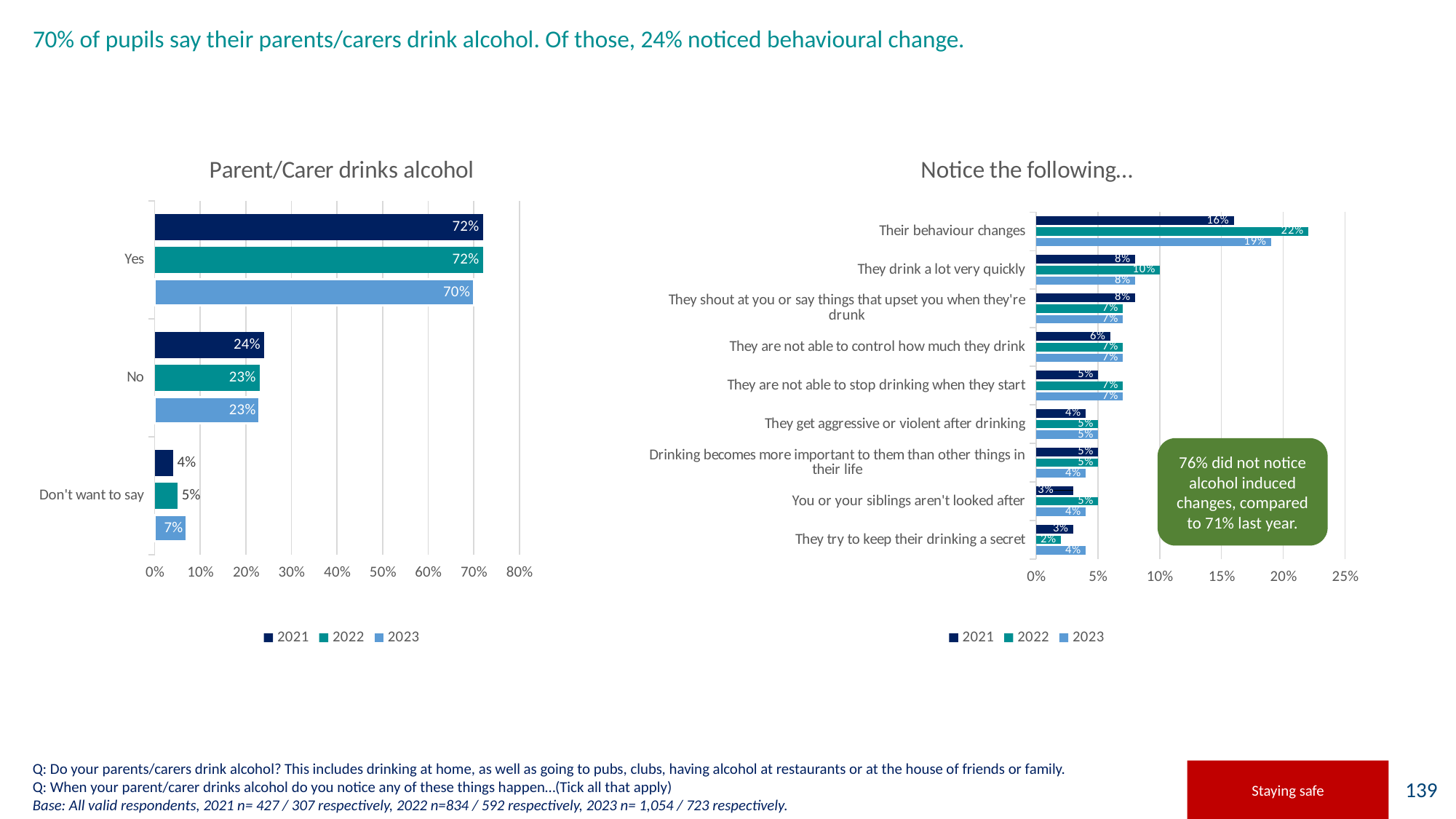
In the 'Notice the following...' chart, how many categories are shown? 9 In the 'Parent/Carer drinks alcohol' chart, what is the difference between the 2021 and 2023 values for 'Don't want to say'? 3% In the 'Parent/Carer drinks alcohol' chart, what is the 2023 value for 'Yes'? 70% In the 'Parent/Carer drinks alcohol' chart, what is the 2023 value for 'Don't want to say'? 7% In the 'Notice the following...' chart, what is the difference between the 2022 and 2023 values for 'Their behaviour changes'? 3% In the 'Parent/Carer drinks alcohol' chart, what is the 2021 value for 'No'? 24% In the 'Notice the following...' chart, what is the 2023 value for 'They drink a lot very quickly'? 8% In the 'Notice the following...' chart, which is larger for 'Their behaviour changes': the 2021 value or the 2022 value? 2022 What kind of chart is 'Notice the following...'? Bar chart In the 'Notice the following...' chart, which category has the highest 2023 value? Their behaviour changes In the 'Parent/Carer drinks alcohol' chart, how many series does the legend list? 3 In the 'Notice the following...' chart, what is the 2022 value for 'Their behaviour changes'? 22%